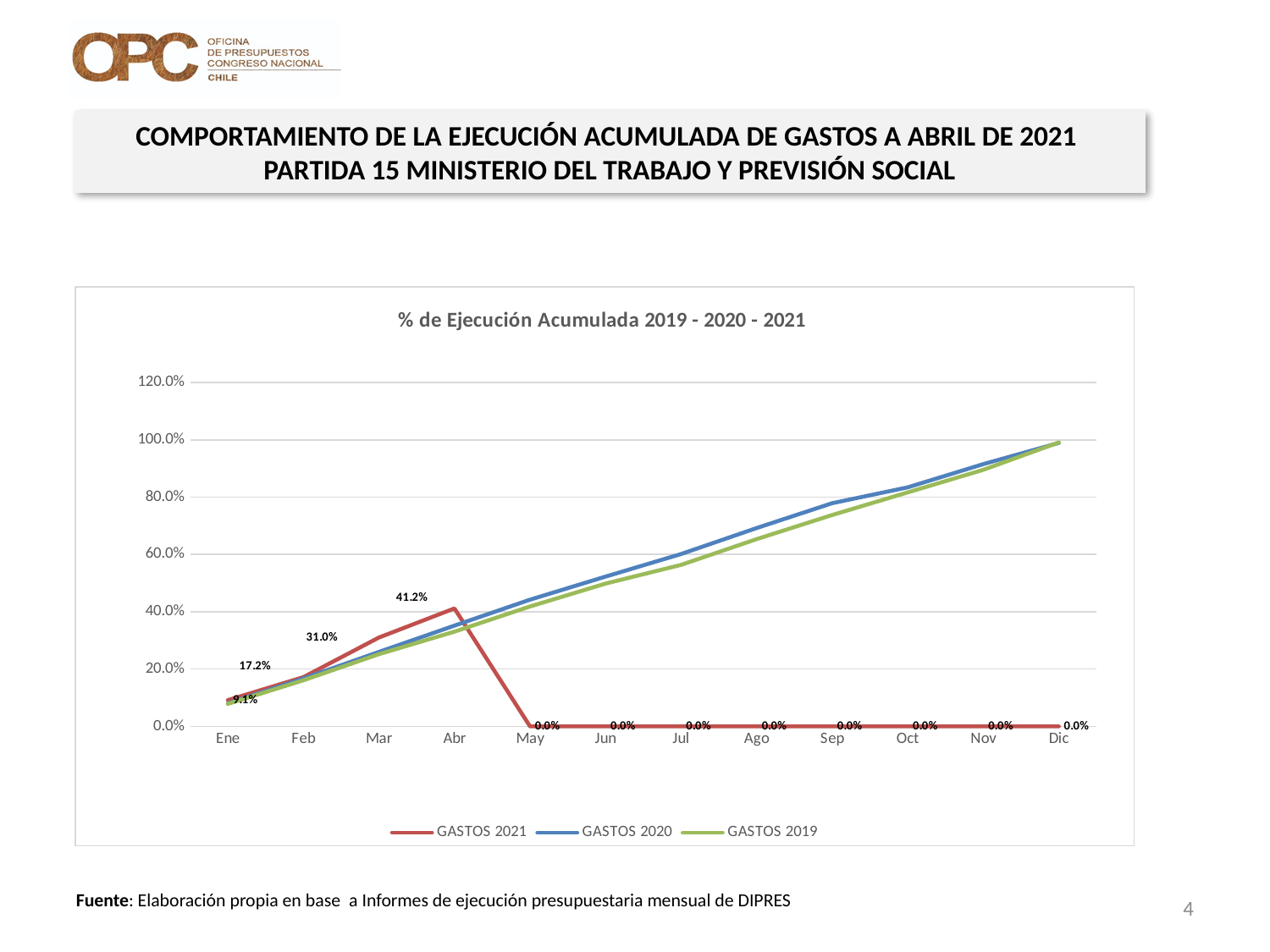
What kind of chart is shown on the slide? Line chart What is the difference between the GASTOS 2021 values for Abr and Mar? 10.2 percentage points What is the value for GASTOS 2021 in Feb? 17.2% In which month does GASTOS 2021 reach its highest value? Abr Does the GASTOS 2020 line rise or fall from Ene to Dic? Rise Is the value for GASTOS 2020 in Sep greater or less than 60.0%? greater Which is larger for GASTOS 2021: the value in Feb or the value in Mar? Mar What is the value for GASTOS 2021 in Abr? 41.2% How many series does the legend list? 3 What is the value for GASTOS 2021 in Mar? 31.0% What is the value for GASTOS 2021 in Ene? 9.1% What is the value for GASTOS 2021 in May? 0.0%